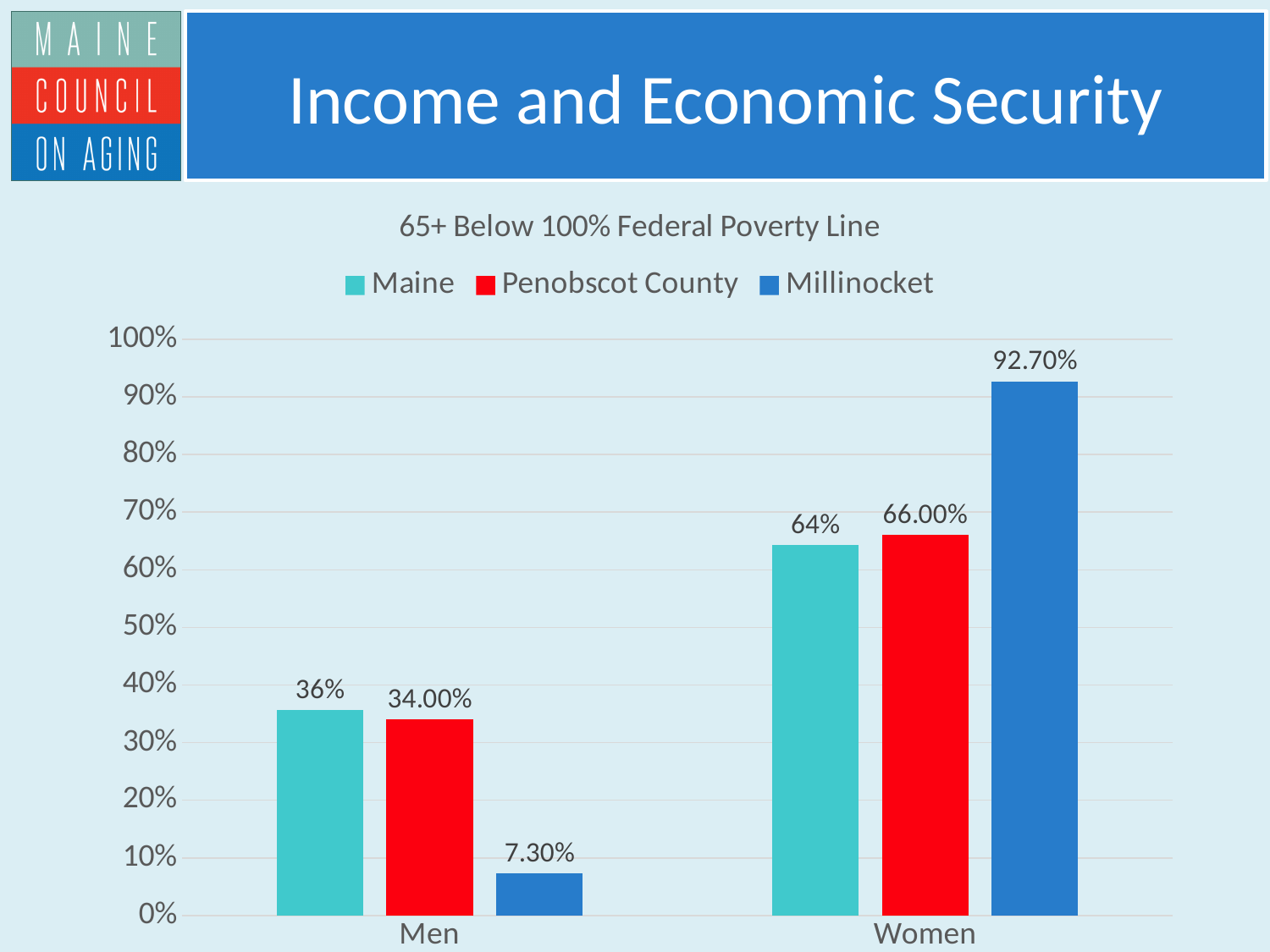
What kind of chart is shown on the slide? Bar chart What is the value for Millinocket in the Men category? 7.30% How many series does the legend list? 3 How many categories are shown on the x axis? 2 What is the value for Maine in the Men category? 36% What is the value for Millinocket in the Women category? 92.70% Which series has the lowest value in the Men category? Millinocket Is the value for Maine in the Women category greater or less than 50%? greater What is the value for Penobscot County in the Men category? 34.00% What is the difference between the Millinocket values for Women and Men? 85.40% Which is larger, the Maine value for Women or the Penobscot County value for Women? Penobscot County Which series has the highest value in the Women category? Millinocket